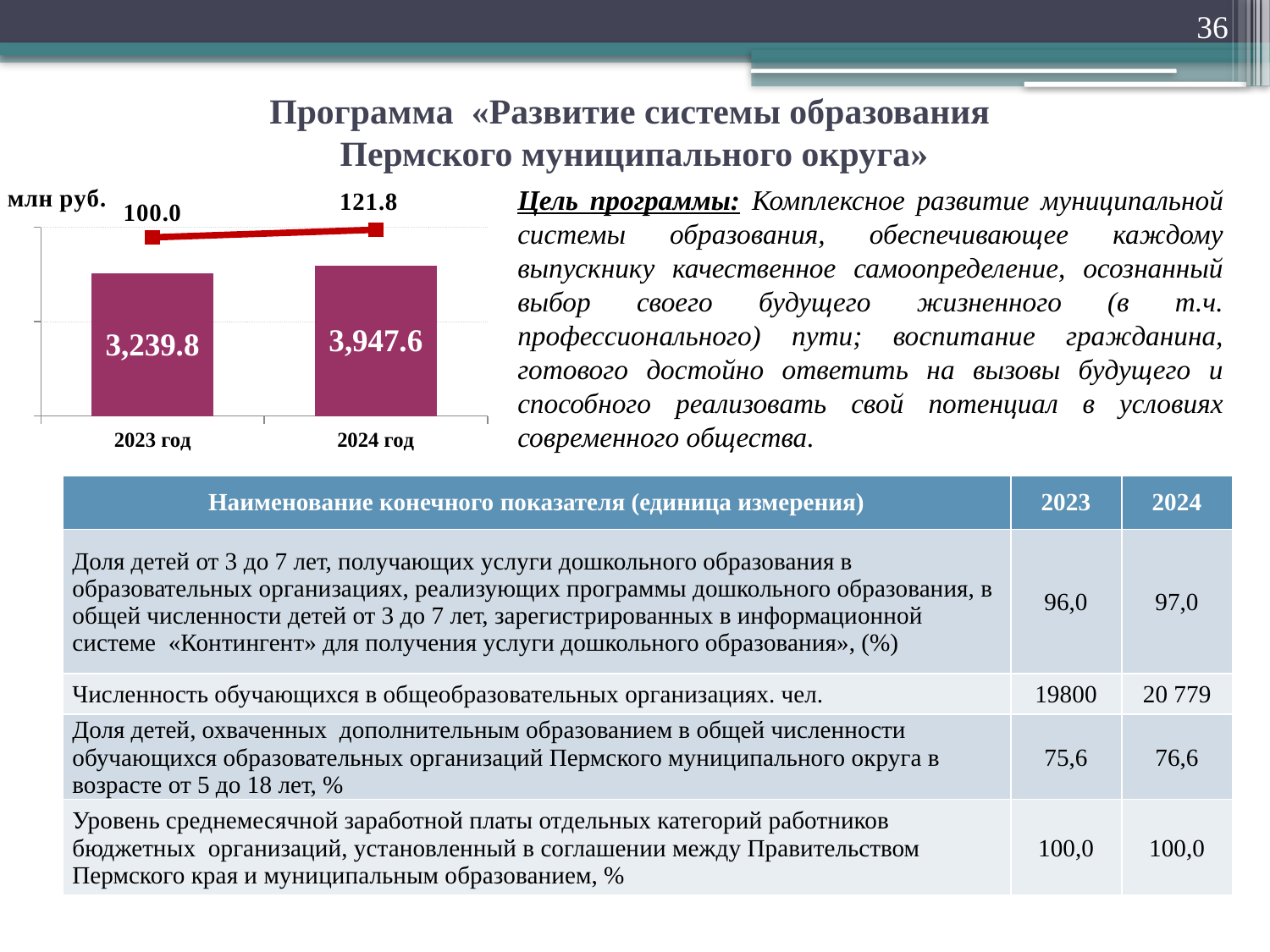
What is the value of the bar for 2024 год? 3,947.6 What unit of measurement is indicated above the chart? млн руб. Which year has the lower bar value? 2023 год What is the difference between the line values for 2024 год and 2023 год? 21.8 What value does the line show for 2023 год? 100.0 What value does the line show for 2024 год? 121.8 Which year has the higher bar value? 2024 год What kind of chart is shown on the slide? combination bar and line chart What is the difference between the bar values for 2024 год and 2023 год? 707.8 How many years (categories) are shown on the x axis of the chart? 2 Is the bar value for 2024 год larger or smaller than the bar value for 2023 год? larger What is the value of the bar for 2023 год? 3,239.8